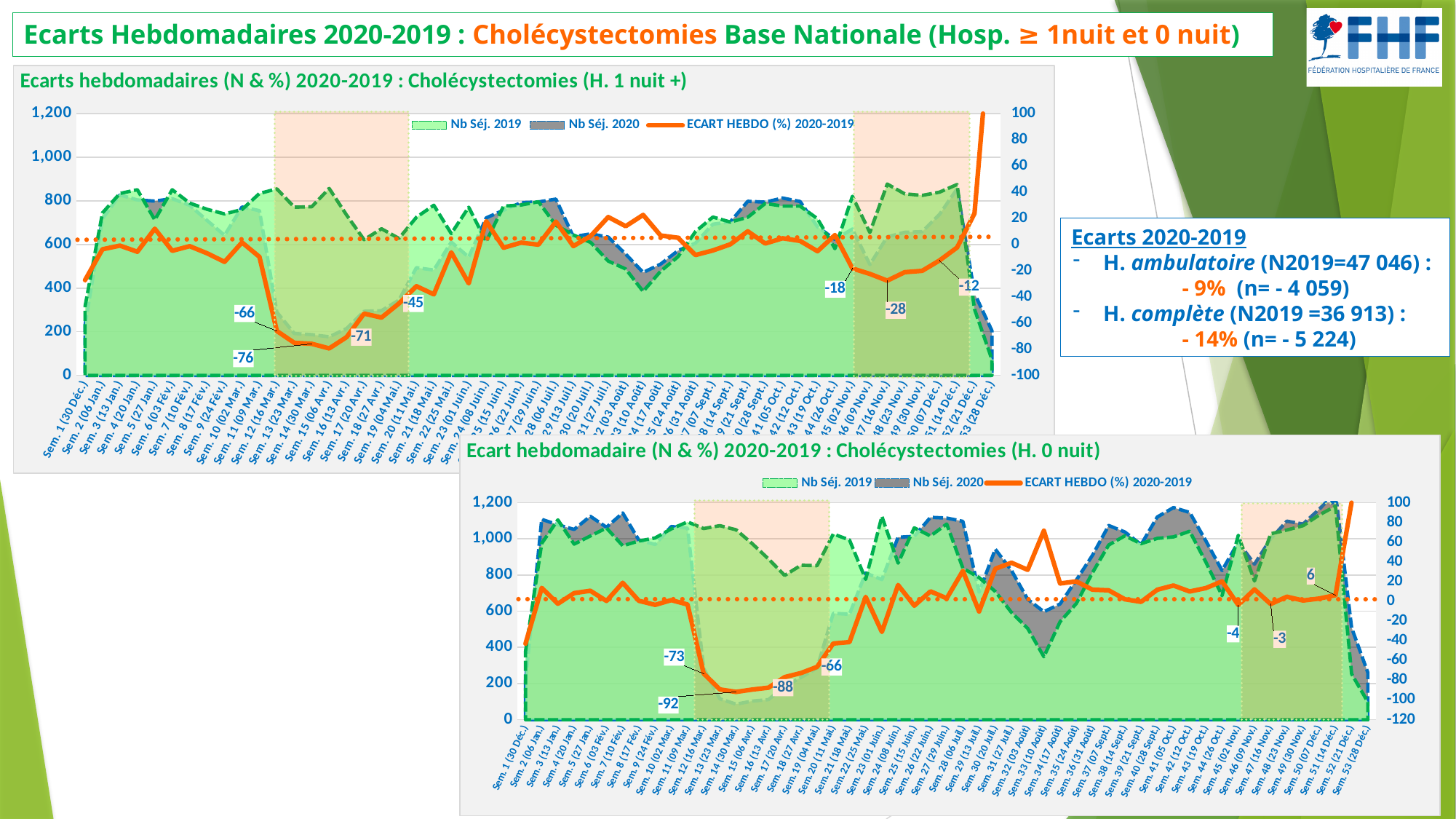
How many series does the legend of the top chart (H. 1 nuit +) list? 3 In the bottom chart (H. 0 nuit), which labelled ECART value is lower, -4 or -3? -4 How many weeks (Sem.) are shown on the x axis of the bottom chart (H. 0 nuit)? 53 What is the minimum value shown on the right axis of the bottom chart (H. 0 nuit)? -120 What kind of chart is used for the ECART HEBDO (%) 2020-2019 series in the top chart? line chart In the bottom chart (H. 0 nuit), what is the only positive value labelled on the ECART HEBDO (%) line? 6 In the bottom chart (H. 0 nuit), what is the difference between the labelled ECART values -88 and -92? 4 In the bottom chart (H. 0 nuit), what is the lowest value labelled on the ECART HEBDO (%) 2020-2019 line? -92 What is the maximum value shown on the left axis of the top chart (H. 1 nuit +)? 1,200 In the top chart (H. 1 nuit +), what is the difference between the labelled ECART values -66 and -76? 10 In the top chart (H. 1 nuit +), is the labelled ECART value -45 greater or less than -40? less In the top chart (H. 1 nuit +), what is the lowest value labelled on the ECART HEBDO (%) 2020-2019 line? -76